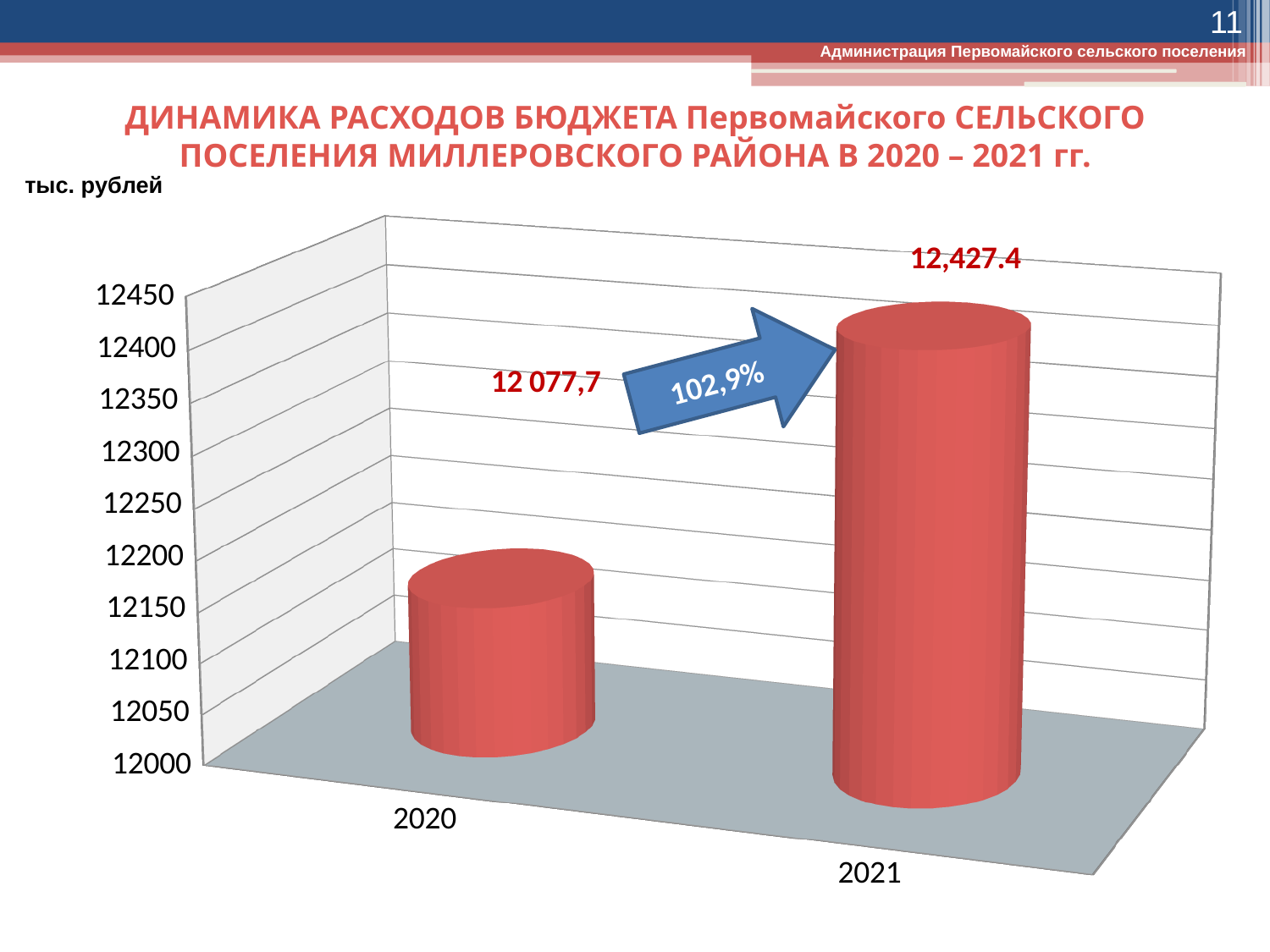
Is the value for 2021 larger than the value for 2020? Yes Which year has the lower budget expenditure? 2020 What is the value for 2020? 12 077,7 What percentage is shown on the arrow between the two bars? 102,9% Do the values rise or fall from 2020 to 2021? Rise Which year has the higher budget expenditure? 2021 What is the difference between the 2021 and 2020 values? 349.7 How many years are shown on the chart? 2 Is the value for 2021 greater or less than 12400? greater What kind of chart is shown on the slide? Bar chart What is the value for 2021? 12,427.4